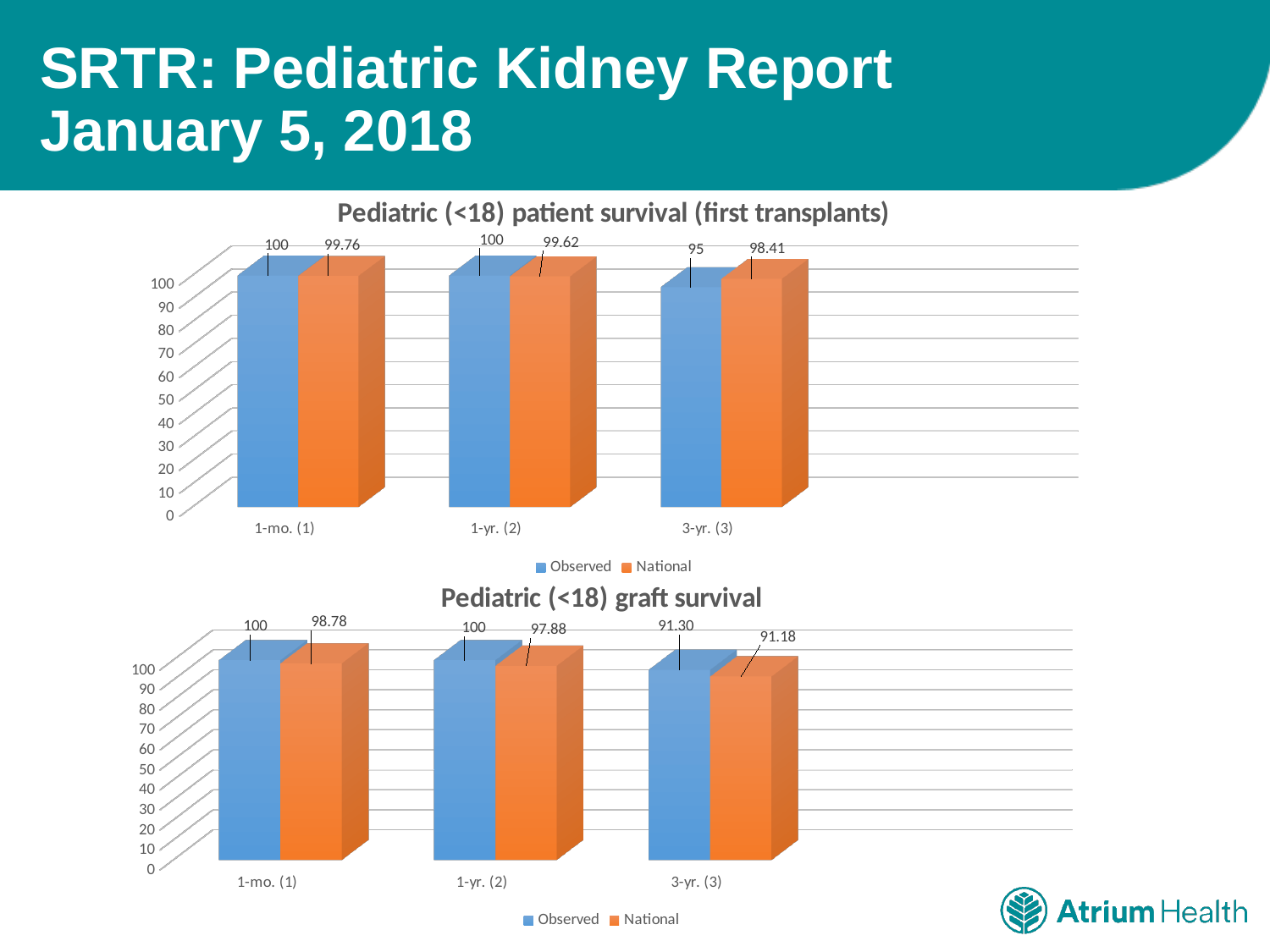
In the 'Pediatric (<18) patient survival (first transplants)' chart, what is the National value for 1-yr. (2)? 99.62 In the 'Pediatric (<18) graft survival' chart, which category has the lowest National value? 3-yr. (3) In the 'Pediatric (<18) patient survival (first transplants)' chart, what is the Observed value for 3-yr. (3)? 95 In the 'Pediatric (<18) graft survival' chart, what is the Observed value for 3-yr. (3)? 91.30 What type of chart is the 'Pediatric (<18) graft survival' chart? bar chart In the 'Pediatric (<18) graft survival' chart, what is the National value for 1-mo. (1)? 98.78 How many series does the legend of the 'Pediatric (<18) graft survival' chart list? 2 In the 'Pediatric (<18) graft survival' chart, is the Observed value for 1-yr. (2) larger or smaller than the National value for 1-yr. (2)? larger How many categories are shown on the x axis of the 'Pediatric (<18) patient survival (first transplants)' chart? 3 What colour represents the National series in the 'Pediatric (<18) patient survival (first transplants)' chart? orange In the 'Pediatric (<18) graft survival' chart, does the National series rise or fall from 1-mo. (1) to 3-yr. (3)? fall In the 'Pediatric (<18) patient survival (first transplants)' chart, what is the difference between the National and Observed values for 3-yr. (3)? 3.41